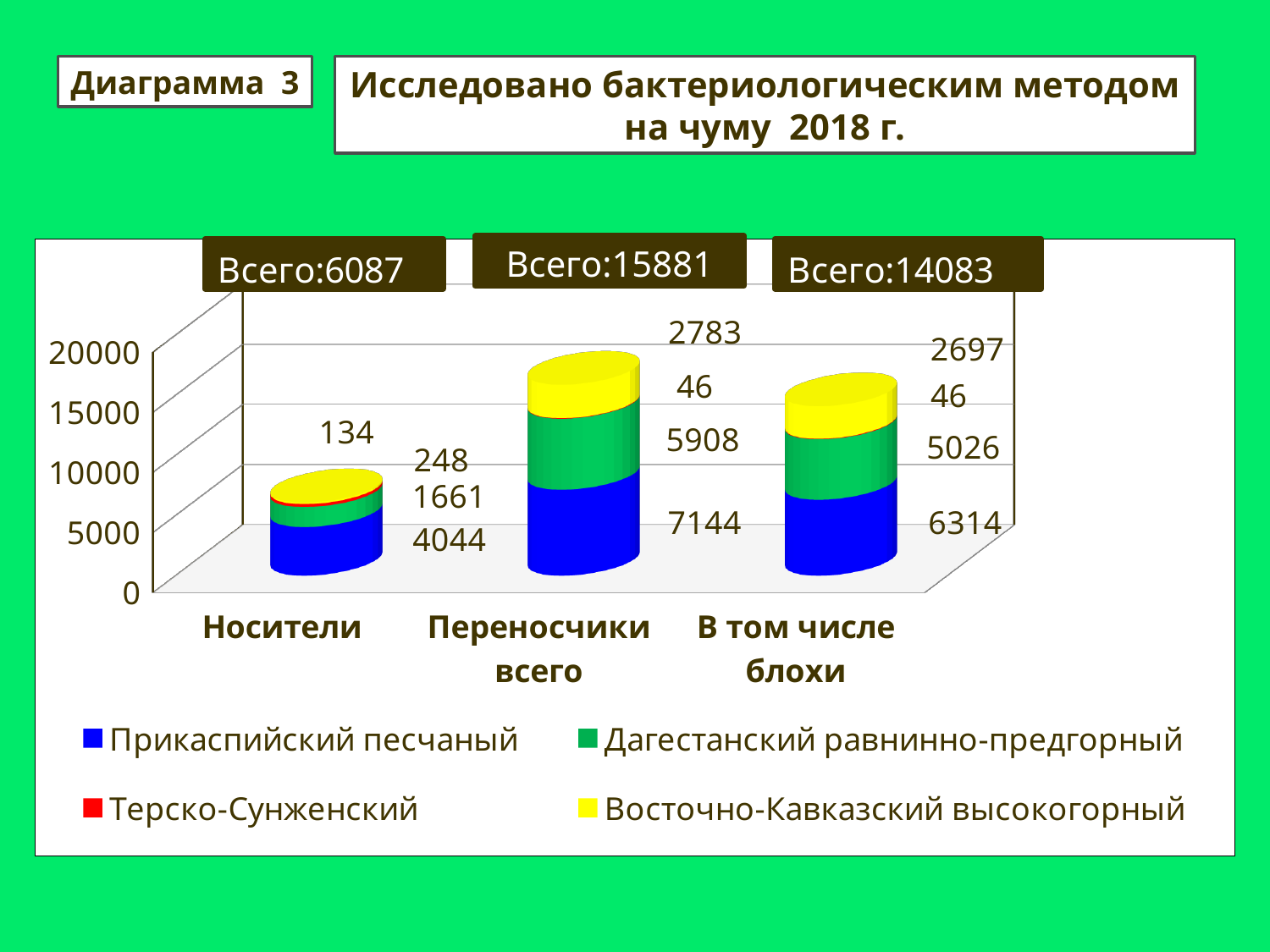
Which category has the highest total (Всего)? Переносчики всего What kind of chart is shown on the slide? Stacked bar chart Which is larger: the Дагестанский равнинно-предгорный value for Носители or for В том числе блохи? В том числе блохи What is the value for Терско-Сунженский in the Носители category? 248 What is the total (Всего) shown for the Переносчики всего category? 15881 What is the difference between the Прикаспийский песчаный values for Переносчики всего and В том числе блохи? 830 What is the value for Прикаспийский песчаный in the Носители category? 4044 How many categories are shown on the x axis? 3 What is the value for Восточно-Кавказский высокогорный in the В том числе блохи category? 2697 What is the value for Дагестанский равнинно-предгорный in the Переносчики всего category? 5908 How many series does the legend list? 4 Which category has the lowest total (Всего)? Носители